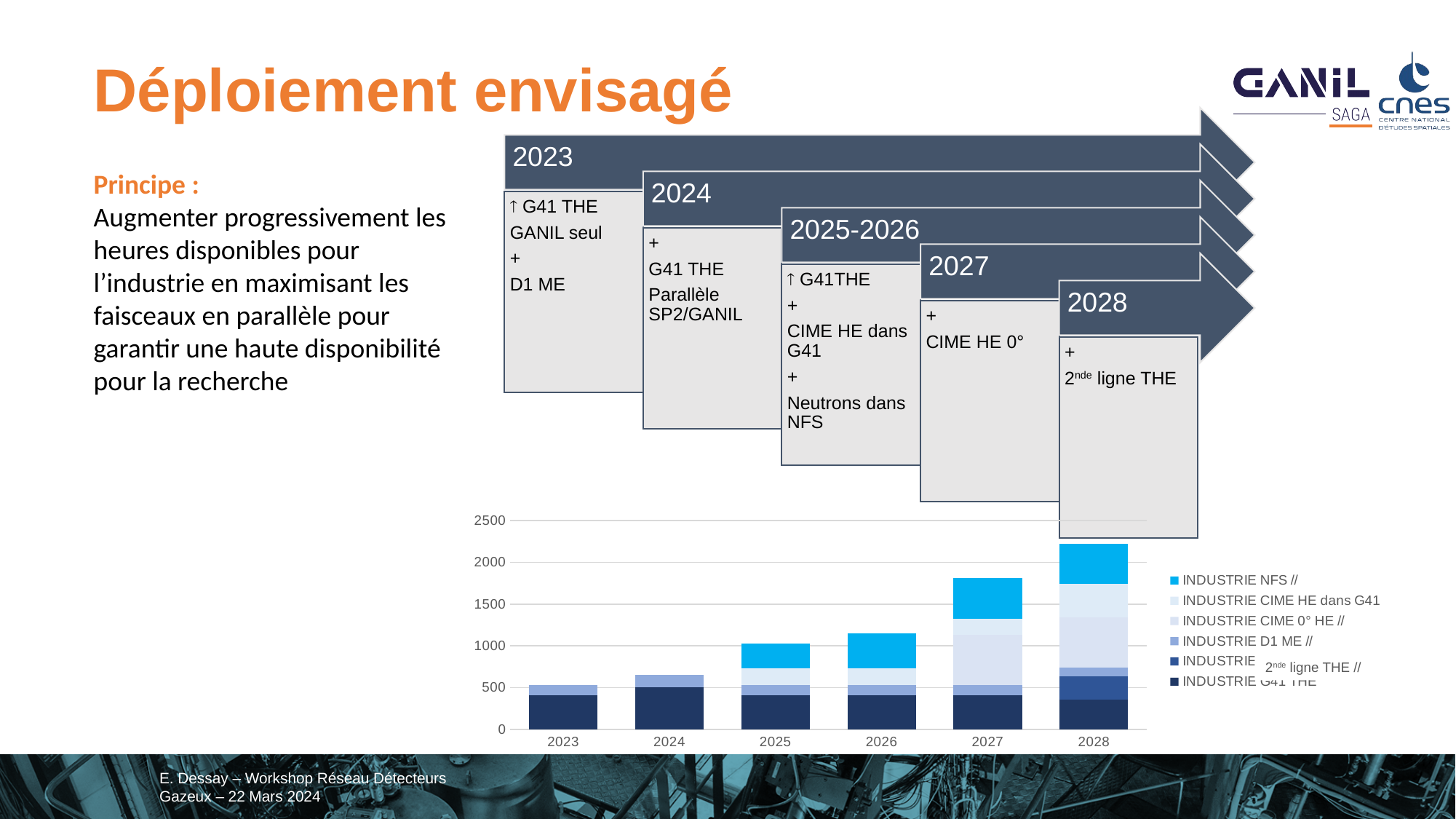
Is the total bar height for 2027 greater or less than 1500? greater What kind of chart is shown at the bottom of the slide? stacked bar chart Which year has the larger total bar, 2026 or 2027? 2027 Is the total bar height for 2024 greater or less than 1000? less How many years are shown on the x axis of the chart? 6 Which series is listed first (at the top) in the chart legend? INDUSTRIE NFS // Do the total bar heights rise or fall from 2023 to 2028? rise Is the total bar height for 2023 greater or less than 1000? less How many series does the chart legend list? 6 Which year has the shortest stacked bar? 2023 Which year has the tallest stacked bar? 2028